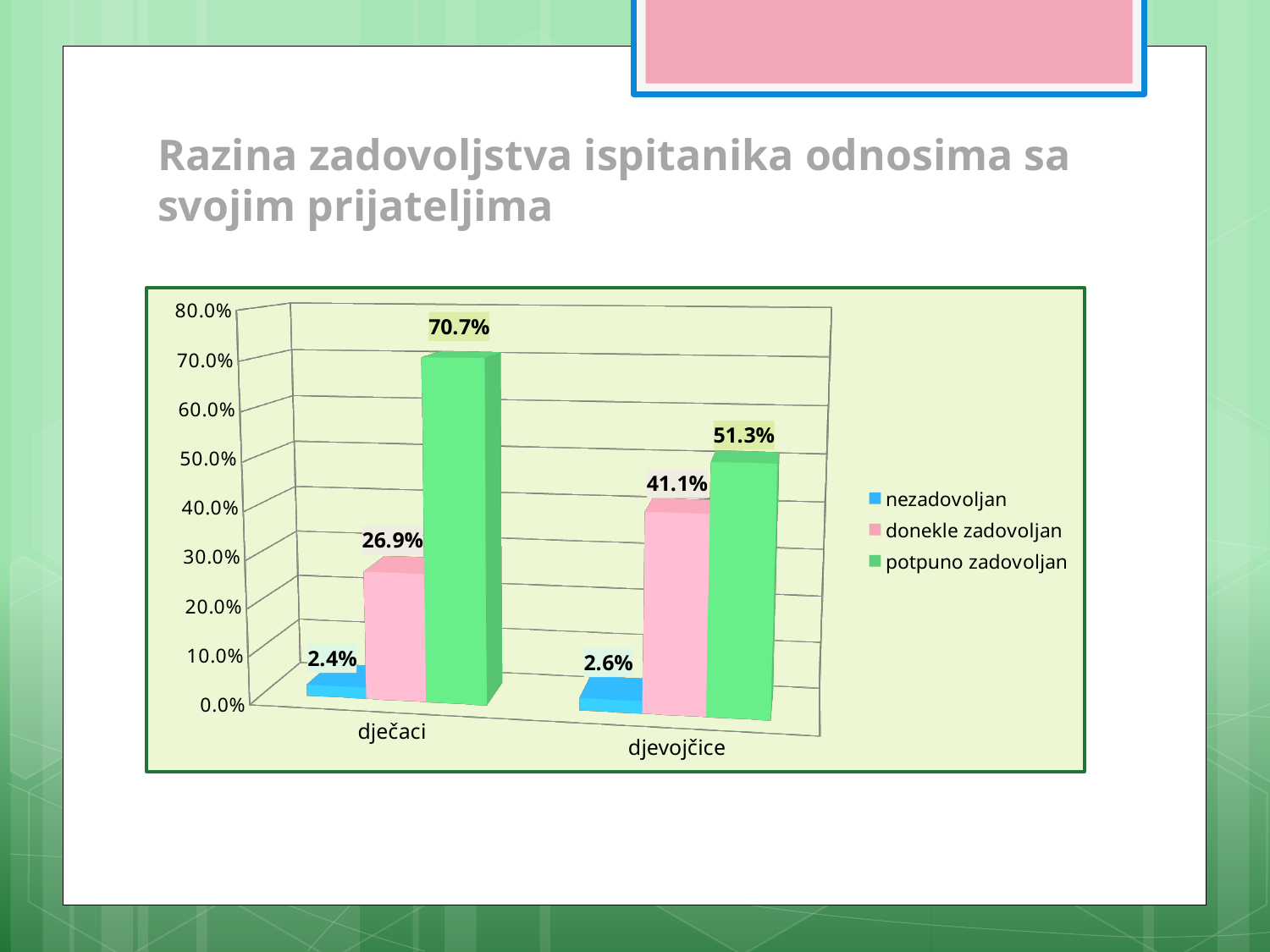
What is the value for 'donekle zadovoljan' among djevojčice? 41.1% How many categories are shown on the x axis? 2 What kind of chart is shown on the slide? bar chart How many series does the legend list? 3 Which group has the larger 'donekle zadovoljan' value, dječaci or djevojčice? djevojčice What is the value for 'nezadovoljan' among dječaci? 2.4% Which series has the lowest value for djevojčice? nezadovoljan What is the value for 'potpuno zadovoljan' among djevojčice? 51.3% Which series has the highest value for dječaci? potpuno zadovoljan What is the value for 'potpuno zadovoljan' among dječaci? 70.7% What colour represents the 'nezadovoljan' series? blue What is the difference between the 'potpuno zadovoljan' values for dječaci and djevojčice? 19.4%